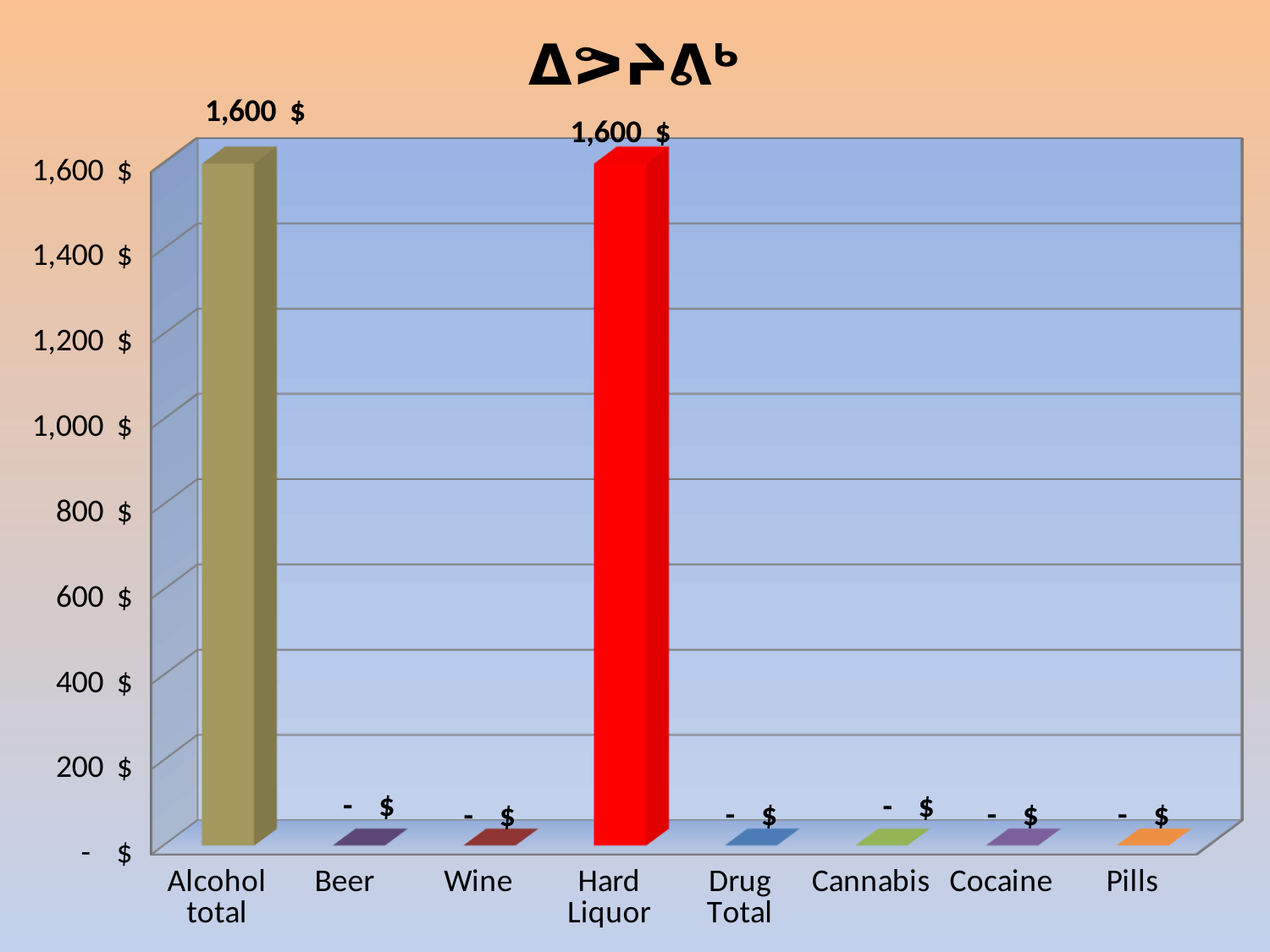
Is the value for Wine greater or less than 200 $? less What kind of chart is shown on the slide? bar chart Is the value for Hard Liquor greater or less than 1,000 $? greater What is the value for Hard Liquor? 1,600 $ What is the value for Alcohol total? 1,600 $ How many categories are shown on the x axis? 8 What is the data label shown for Beer? - $ What colour is the Hard Liquor bar? red What is the data label shown for Cannabis? - $ Which two categories have the highest value? Alcohol total and Hard Liquor Which is larger, the value for Alcohol total or the value for Beer? Alcohol total Which is larger, the value for Hard Liquor or the value for Drug Total? Hard Liquor